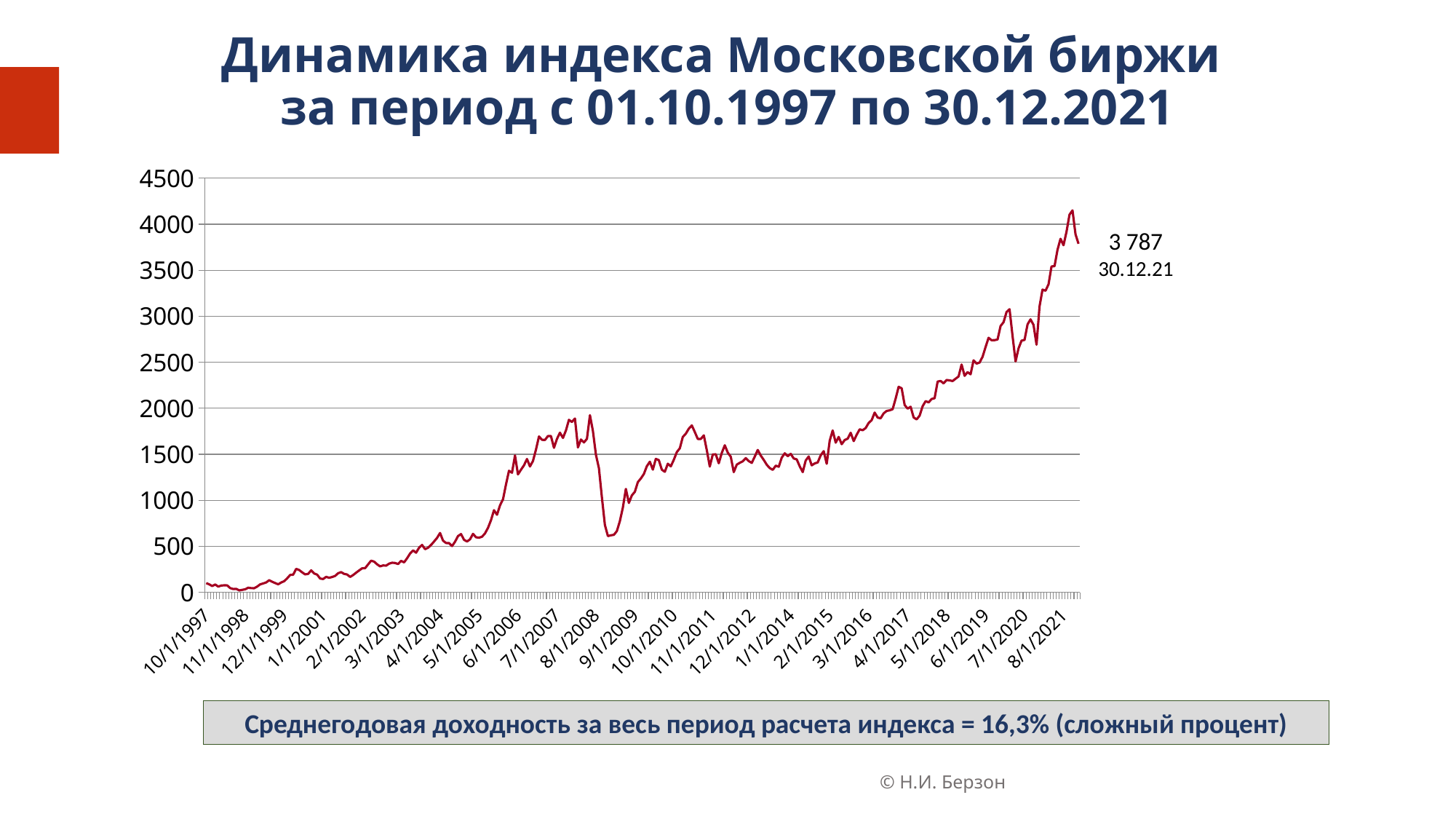
Is the value of the index at 10/1/1997 greater or less than 500? less How many data series are plotted on the chart? 1 Does the index generally rise or fall from 10/1/1997 to 8/1/2021? rise Is the value of the index at 8/1/2021 greater or less than 3000? greater Is the value of the index at 1/1/2014 greater or less than 2000? less What value of the Moscow Exchange index is labelled for 30.12.21? 3 787 Which is larger: the index value at 8/1/2021 or at 10/1/1997? 8/1/2021 What is the highest value shown on the vertical axis? 4500 What kind of chart is shown on the slide? line chart What is the title of the chart? Динамика индекса Московской биржи за период с 01.10.1997 по 30.12.2021